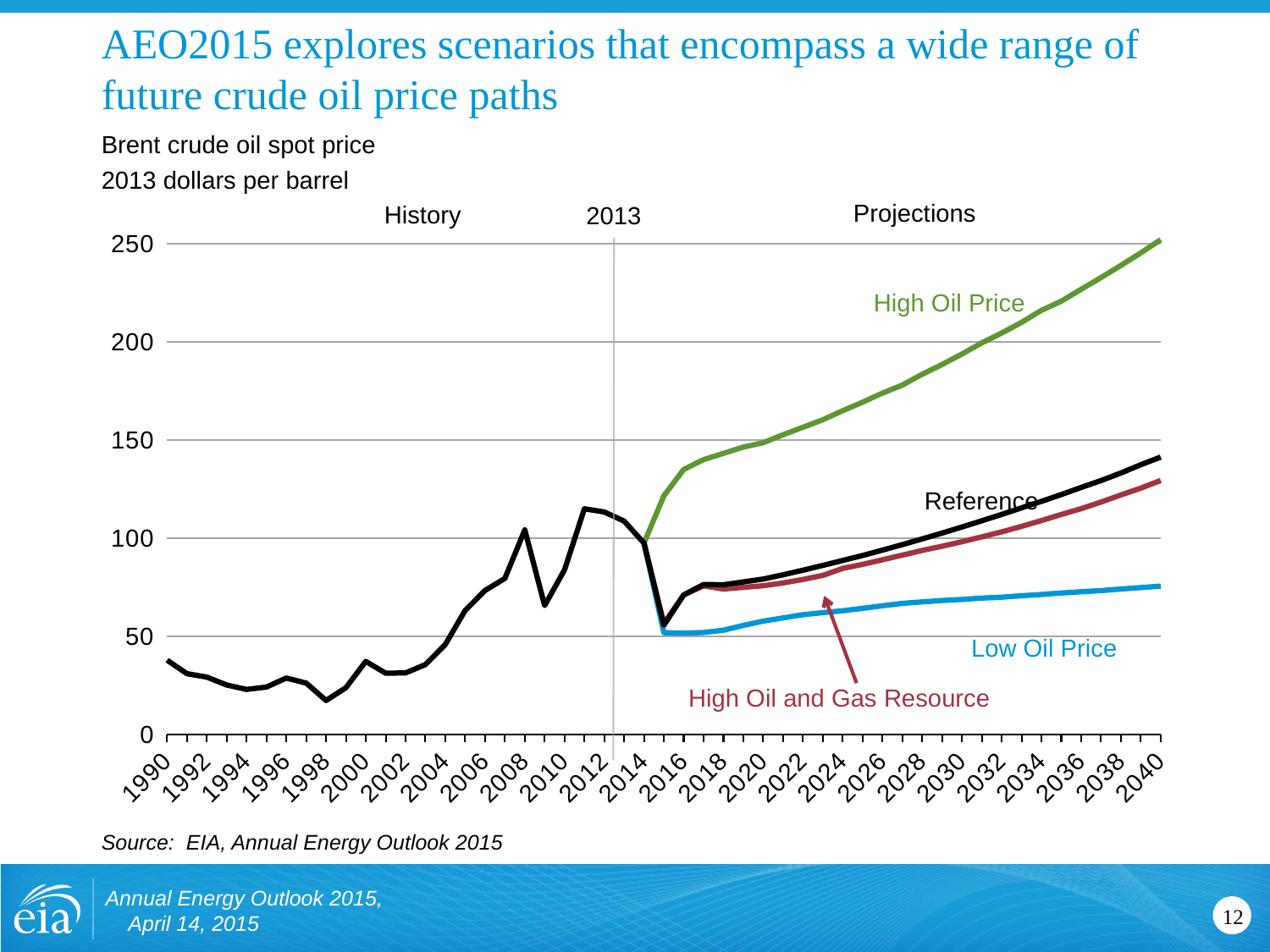
Is the historical Brent price in 1998 greater or less than 50? less Does the High Oil Price line rise or fall between 2014 and 2040? rise Which year marks the boundary between History and Projections on the chart? 2013 Is the High Oil Price value in 2040 greater or less than 200? greater What kind of chart is shown on the slide? line chart Is the Reference case value in 2040 greater or less than 100? greater In 2040, which is larger: the Reference case or the High Oil and Gas Resource case? Reference How many projection scenarios are labeled on the chart? 4 In what units is the Brent crude oil spot price expressed on the chart? 2013 dollars per barrel Which projection scenario has the lowest Brent crude oil price in 2040? Low Oil Price Which projection scenario has the highest Brent crude oil price in 2040? High Oil Price